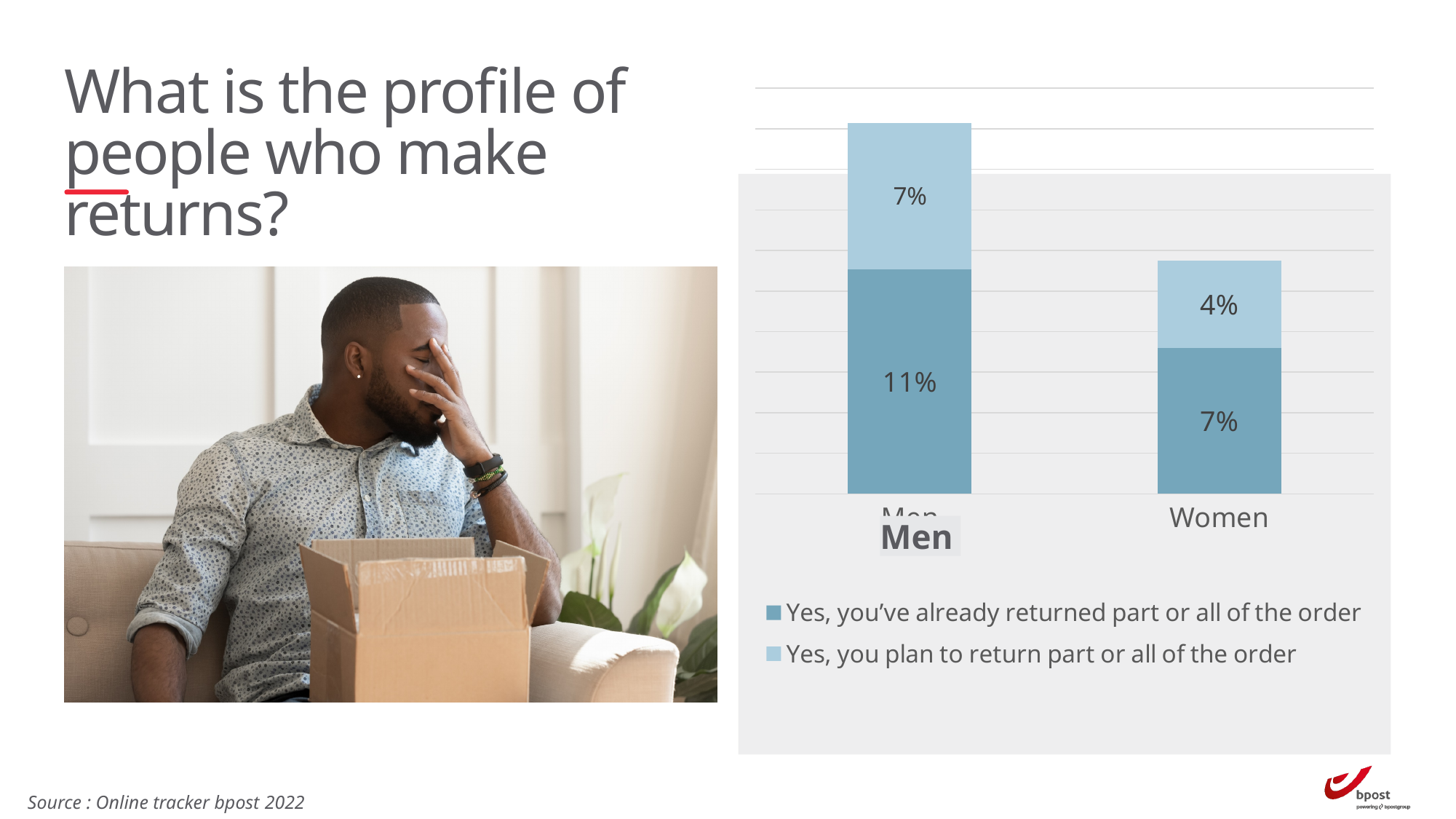
Is the value for men who have already returned part or all of the order larger than the value for women who have already returned part or all of the order? Yes What percentage of women plan to return part or all of the order? 4% Which category has the higher value for 'Yes, you've already returned part or all of the order'? Men What percentage of men have already returned part or all of the order? 11% What is the difference between men and women for 'Yes, you've already returned part or all of the order'? 4% What percentage of men plan to return part or all of the order? 7% How many series does the legend list? 2 How many categories are shown on the x axis? 2 What percentage of women have already returned part or all of the order? 7% What is the total of the stacked bar for Men? 18% Which category has the lower value for 'Yes, you plan to return part or all of the order'? Women What is the total of the stacked bar for Women? 11%